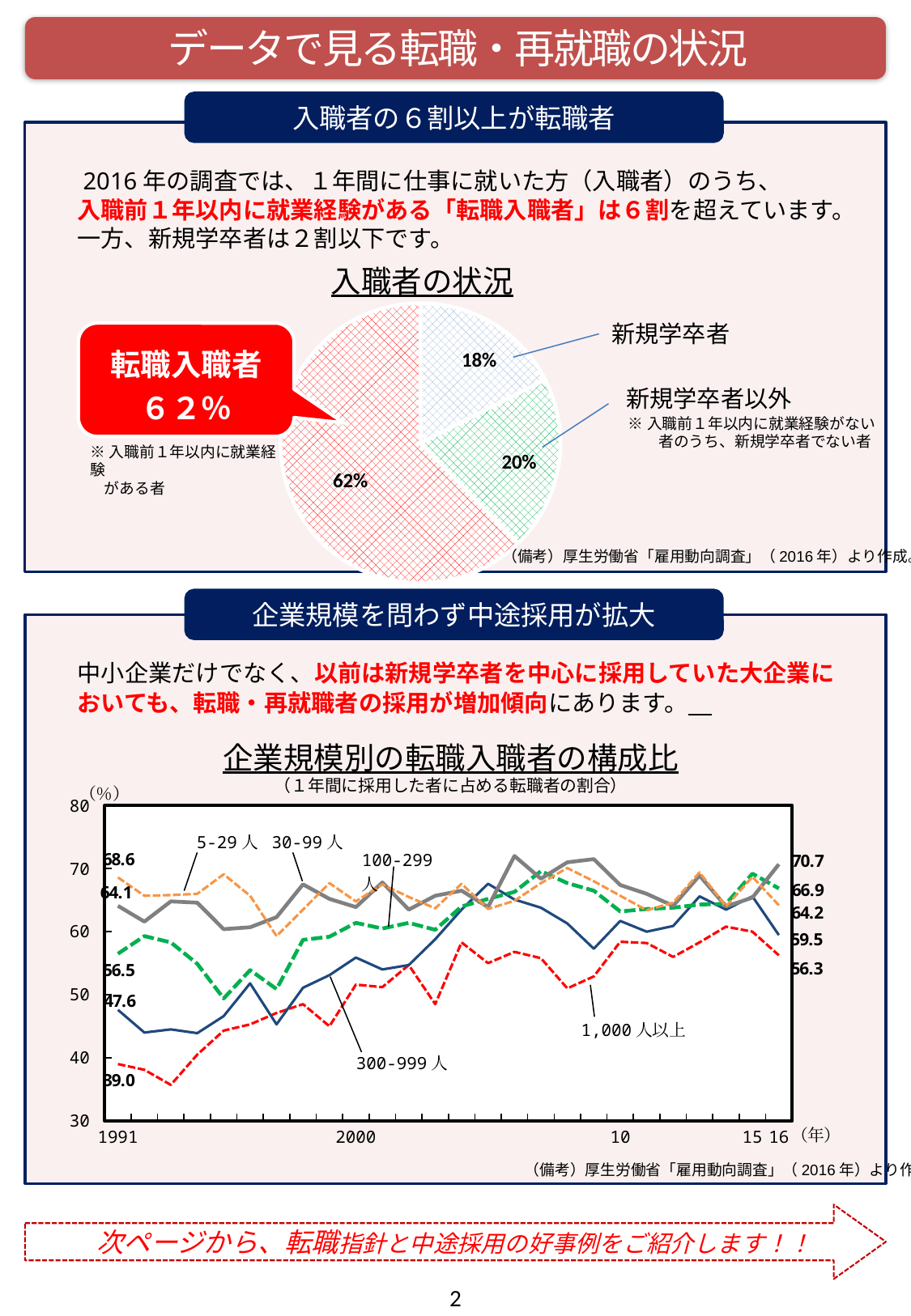
In the chart 企業規模別の転職入職者の構成比, what is the value for 1,000人以上 in 1991? 39.0 In the chart 企業規模別の転職入職者の構成比, what is the value for 300-999人 in 1991? 47.6 In the pie chart 入職者の状況, what share is shown for 転職入職者? 62% In the pie chart 入職者の状況, what share is shown for 新規学卒者? 18% How many company-size series are plotted in the chart 企業規模別の転職入職者の構成比? 5 What kind of chart is 企業規模別の転職入職者の構成比? Line chart In the chart 企業規模別の転職入職者の構成比, which company-size series has the lowest value in 1991? 1,000人以上 In the chart 企業規模別の転職入職者の構成比, does the value for 1,000人以上 rise or fall from 1991 to 2016? Rise In the pie chart 入職者の状況, which slice is the smallest? 新規学卒者 (18%) In the pie chart 入職者の状況, how many slices are there? 3 In the chart 企業規模別の転職入職者の構成比, what is the value for 1,000人以上 in 2016? 56.3 In the pie chart 入職者の状況, how many percentage points larger is the 転職入職者 slice than the 新規学卒者 slice? 44 percentage points